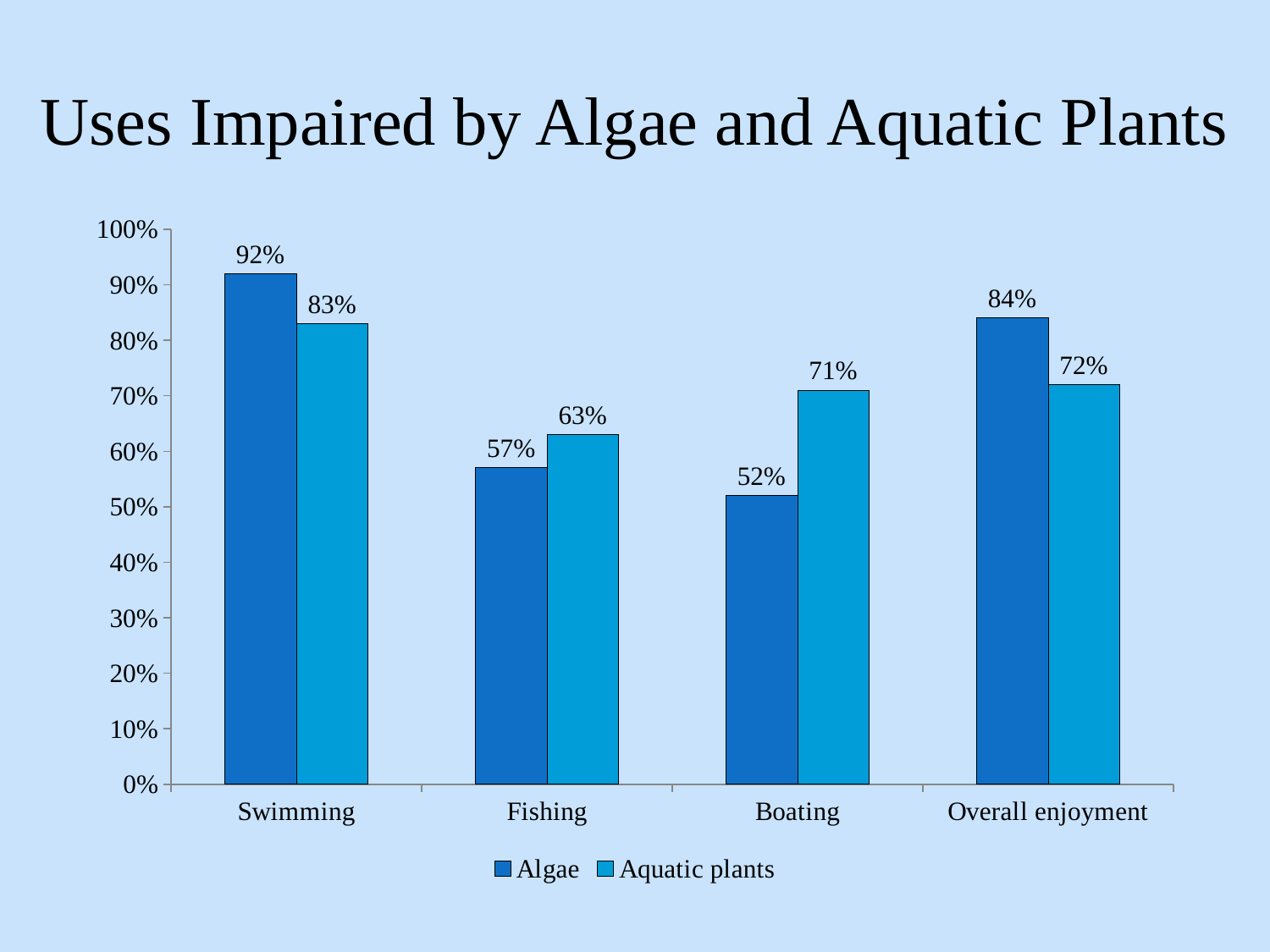
What is the Algae value for Overall enjoyment? 84% What is the Algae value for Swimming? 92% How many categories are shown on the x axis? 4 What is the Aquatic plants value for Boating? 71% Which category has the lowest Aquatic plants value? Fishing What is the title of the chart? Uses Impaired by Algae and Aquatic Plants Which is larger for Fishing, the Algae value or the Aquatic plants value? Aquatic plants What is the difference between the Algae and Aquatic plants values for Boating? 19% Is the Algae value for Boating greater or less than 60%? less How many series does the legend list? 2 What kind of chart is shown on the slide? bar chart Which category has the highest Algae value? Swimming